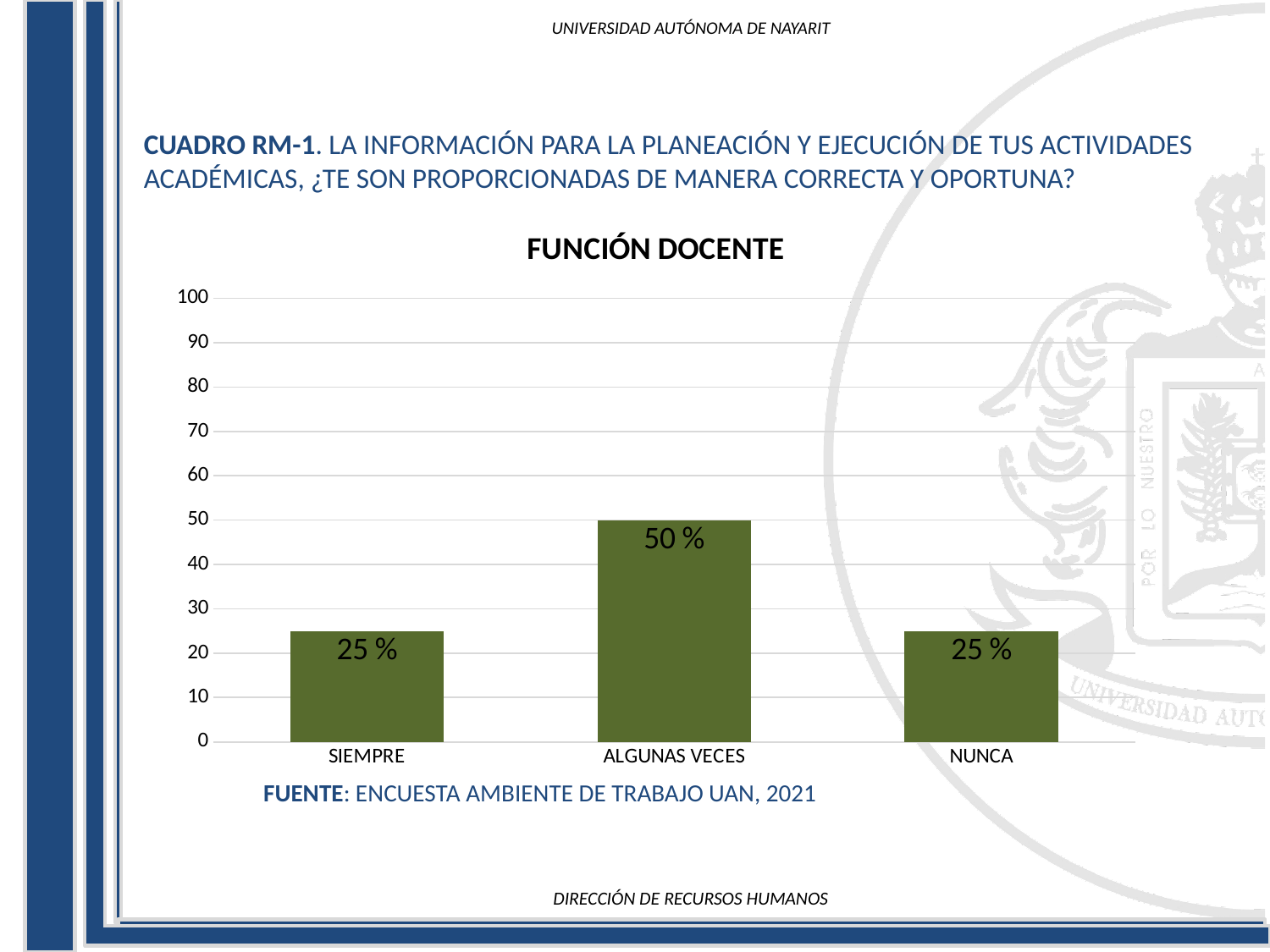
What is the value for ALGUNAS VECES? 50 % What is the maximum value shown on the y axis? 100 What kind of chart is shown? bar chart What is the value for NUNCA? 25 % Which is larger, the value for ALGUNAS VECES or the value for NUNCA? ALGUNAS VECES How many categories are shown on the x axis? 3 What is the value for SIEMPRE? 25 % What is the difference between the values for ALGUNAS VECES and SIEMPRE? 25 % What is the title of the chart? FUNCIÓN DOCENTE Is the value for NUNCA greater or less than 30? less Which category has the highest value? ALGUNAS VECES Is the value for ALGUNAS VECES greater or less than 40? greater